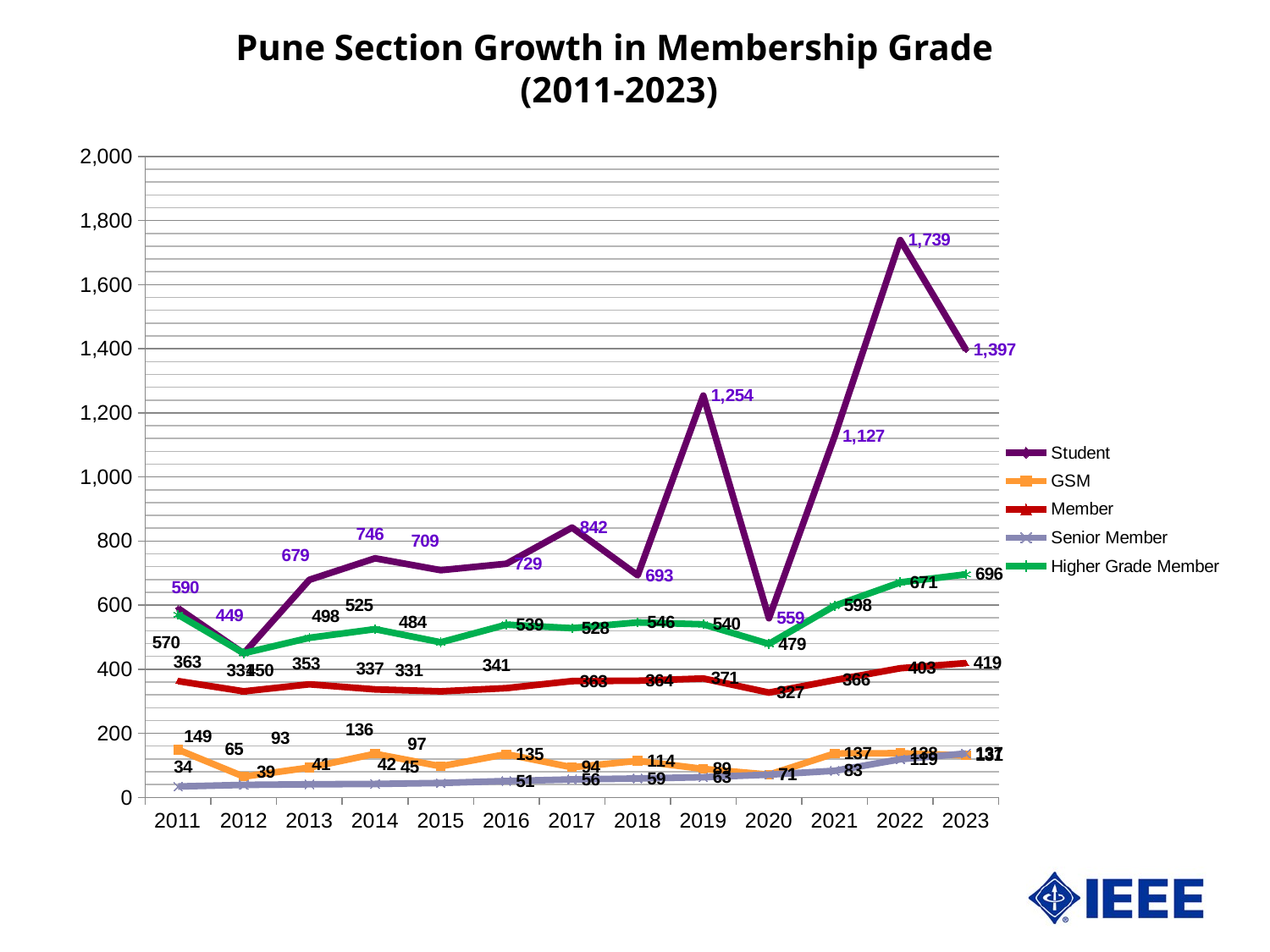
What is the Student value in 2022? 1,739 Which year has the larger Student value, 2019 or 2021? 2019 In which year is the Student series at its lowest? 2012 What is the GSM value in 2011? 149 What is the Senior Member value in 2011? 34 By how much did the Student value fall from 2022 to 2023? 342 Is the Student value for 2020 greater or less than 600? less What is the Member value in 2020? 327 In which year does the Student series reach its highest value? 2022 How many series does the legend list? 5 What is the Higher Grade Member value in 2023? 696 What kind of chart is shown on the slide? line chart